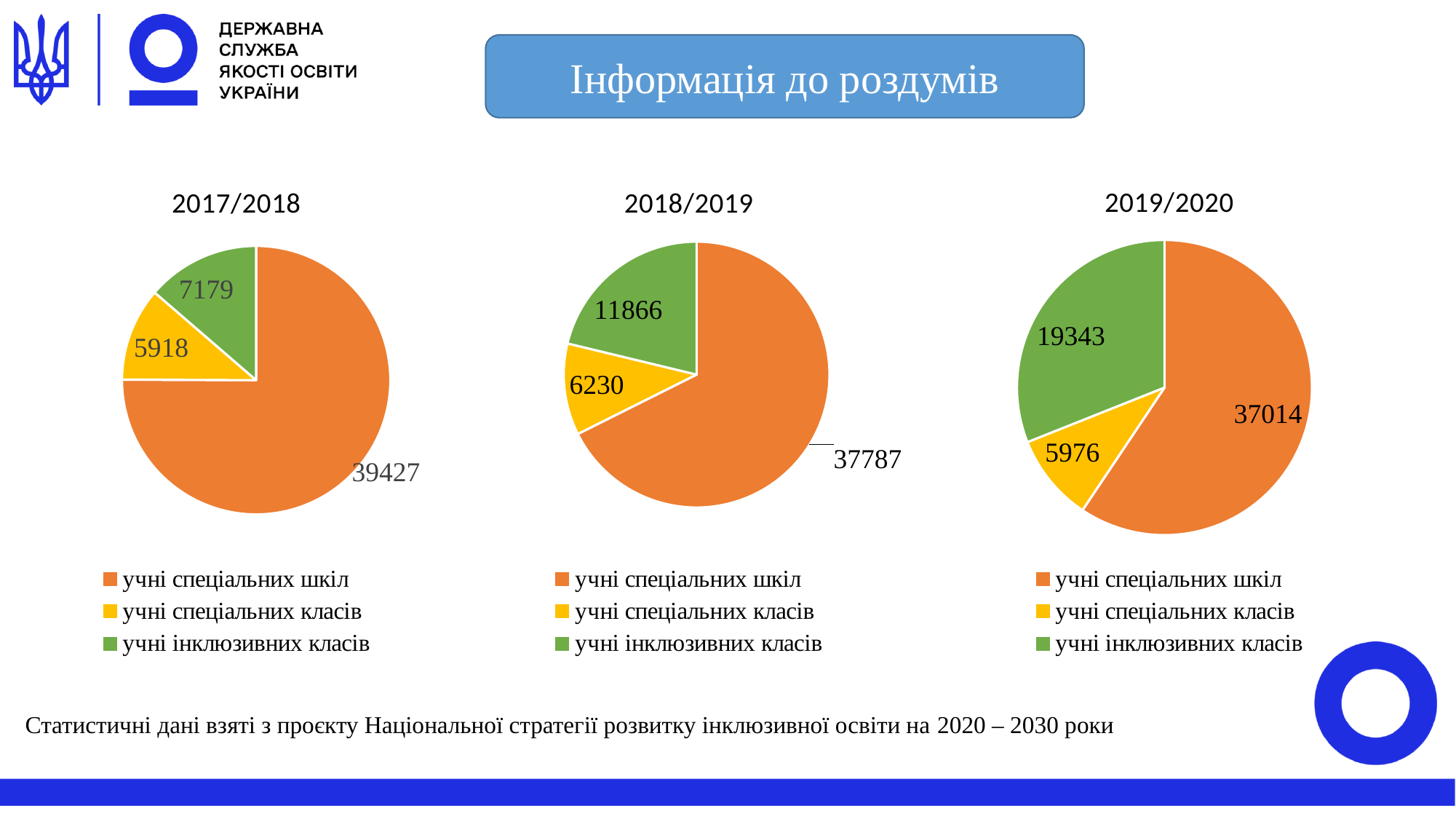
In the 2019/2020 chart, how much larger is учні спеціальних шкіл than учні інклюзивних класів? 17671 In the 2019/2020 chart, which category has the largest slice? учні спеціальних шкіл In the 2017/2018 chart, which category has the smallest slice? учні спеціальних класів In the 2017/2018 chart, what is the value for учні спеціальних шкіл? 39427 Which is larger: учні інклюзивних класів in 2019/2020 or учні інклюзивних класів in 2017/2018? 2019/2020 In the 2019/2020 chart, what is the value for учні спеціальних класів? 5976 What type of chart is used for 2019/2020? pie chart How many slices does the 2018/2019 pie chart have? 3 What is the total of all three slices in the 2017/2018 chart? 52524 In the 2018/2019 chart, what is the value for учні інклюзивних класів? 11866 In the 2018/2019 chart, what is the difference between учні інклюзивних класів and учні спеціальних класів? 5636 Across the three charts from 2017/2018 to 2019/2020, does the value for учні інклюзивних класів rise or fall? rise